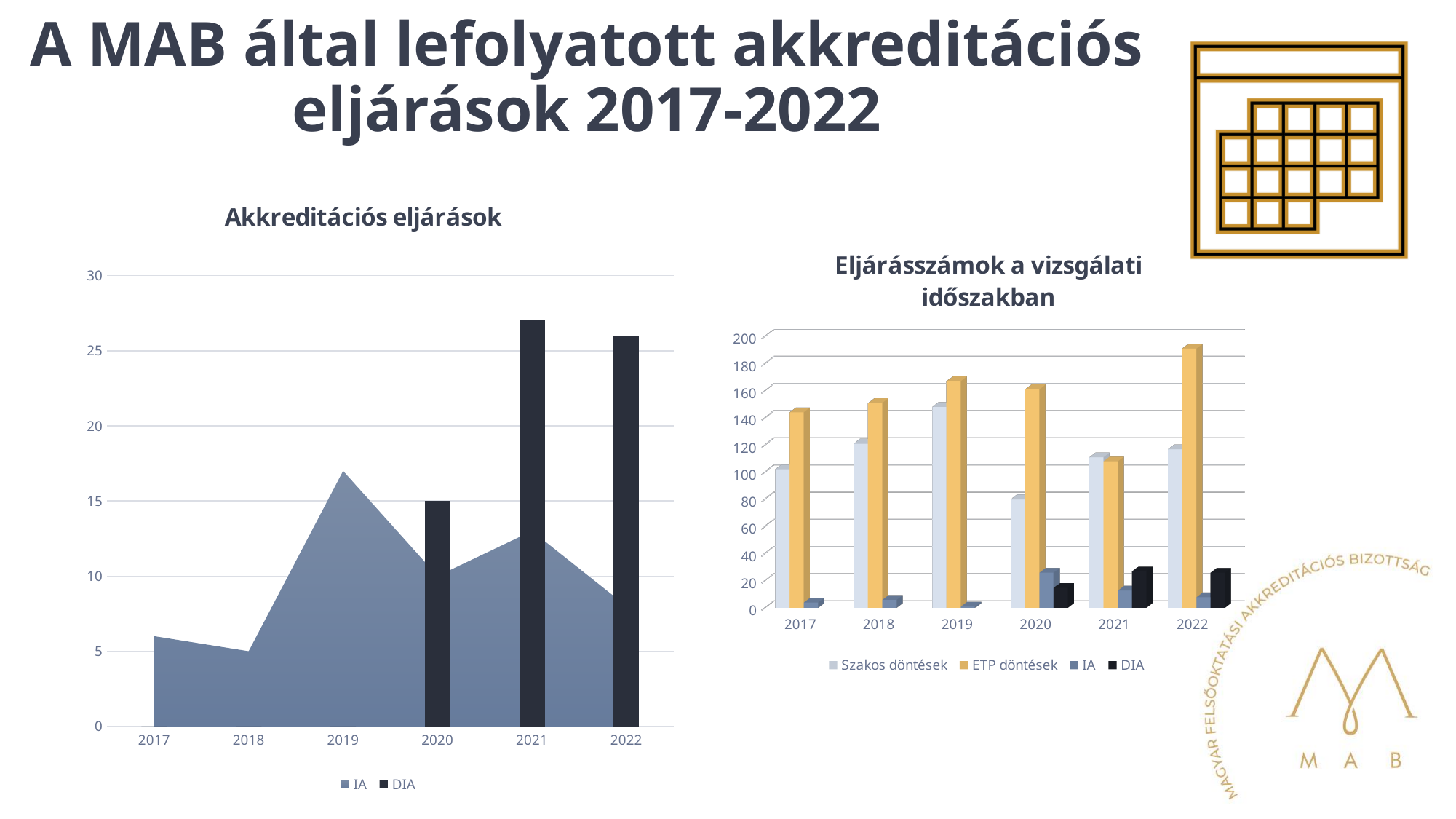
In the chart titled 'Akkreditációs eljárások', is the DIA value for 2021 greater or less than 25? greater In the chart titled 'Eljárásszámok a vizsgálati időszakban', is the Szakos döntések value for 2020 greater or less than 100? less In the chart titled 'Akkreditációs eljárások', which year has the highest IA value? 2019 In the chart titled 'Eljárásszámok a vizsgálati időszakban', which year has the lowest Szakos döntések value? 2020 How many years are shown on the x axis of the chart titled 'Eljárásszámok a vizsgálati időszakban'? 6 How many series does the legend of the chart titled 'Eljárásszámok a vizsgálati időszakban' list? 4 How many series does the legend of the chart titled 'Akkreditációs eljárások' list? 2 In the chart titled 'Eljárásszámok a vizsgálati időszakban', which is larger in 2019: Szakos döntések or ETP döntések? ETP döntések In the chart titled 'Akkreditációs eljárások', which is larger: the IA value for 2018 or for 2019? 2019 What kind of chart is the chart titled 'Eljárásszámok a vizsgálati időszakban'? bar chart In the chart titled 'Eljárásszámok a vizsgálati időszakban', is the ETP döntések value for 2022 greater or less than 180? greater In the chart titled 'Eljárásszámok a vizsgálati időszakban', which year has the highest ETP döntések value? 2022